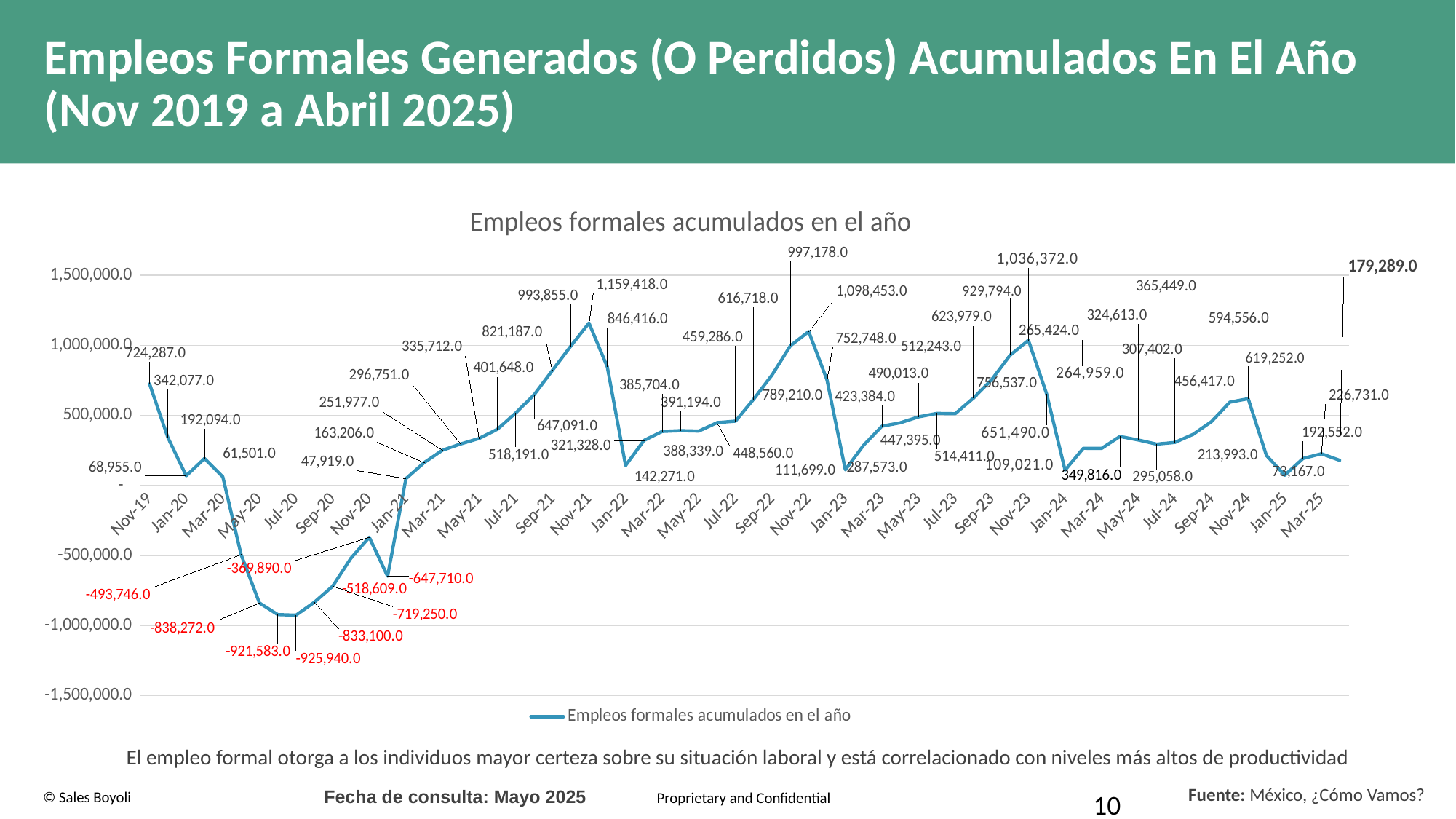
Is the value for Jul-20 greater or less than -500,000.0? less What is the value of the last data point on the chart (Apr-25)? 179,289.0 What is the value for Nov-19, the first point on the chart? 724,287.0 Is the value for Nov-21 greater or less than 1,000,000.0? greater What is the title of the chart? Empleos formales acumulados en el año What is the difference between the highest value (1,159,418.0) and the lowest value (-925,940.0) on the chart? 2,085,358.0 How many data labels on the chart are negative (shown in red)? 9 How many series does the legend list? 1 What is the lowest value plotted on the chart? -925,940.0 What is the highest value plotted on the chart? 1,159,418.0 What kind of chart is shown on the slide? line chart Which is larger: the peak value labelled 1,159,418.0 or the peak value labelled 1,098,453.0? 1,159,418.0